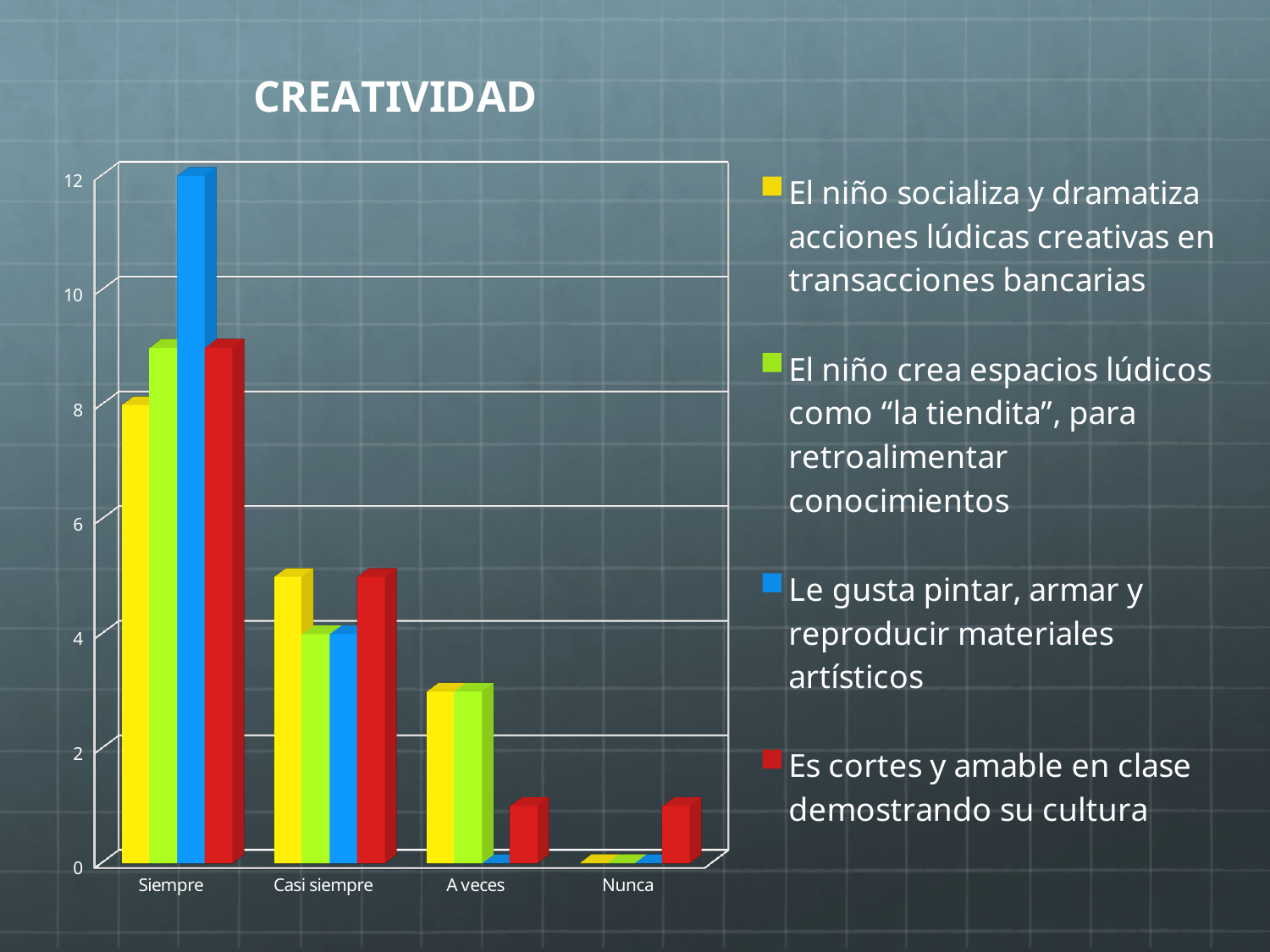
How many categories are shown on the x axis of the chart? 4 For the series 'Le gusta pintar, armar y reproducir materiales artísticos', which category has the highest value? Siempre What colour represents the series 'Es cortes y amable en clase demostrando su cultura' in the chart? red What kind of chart is shown on the slide? bar chart In the Siempre category, which is larger: the value for 'Le gusta pintar, armar y reproducir materiales artísticos' or the value for 'El niño socializa y dramatiza acciones lúdicas creativas en transacciones bancarias'? Le gusta pintar, armar y reproducir materiales artísticos What is the value for 'Le gusta pintar, armar y reproducir materiales artísticos' in the Siempre category? 12 Is the value for 'El niño crea espacios lúdicos como "la tiendita", para retroalimentar conocimientos' in the Siempre category greater or less than 8? greater What is the title of the slide containing the chart? CREATIVIDAD Do the values for 'Le gusta pintar, armar y reproducir materiales artísticos' rise or fall from Siempre to Nunca? fall Is the value for 'Es cortes y amable en clase demostrando su cultura' in the Casi siempre category greater or less than 4? greater How many series does the chart's legend list? 4 Is the value for 'El niño socializa y dramatiza acciones lúdicas creativas en transacciones bancarias' in the A veces category greater or less than 4? less